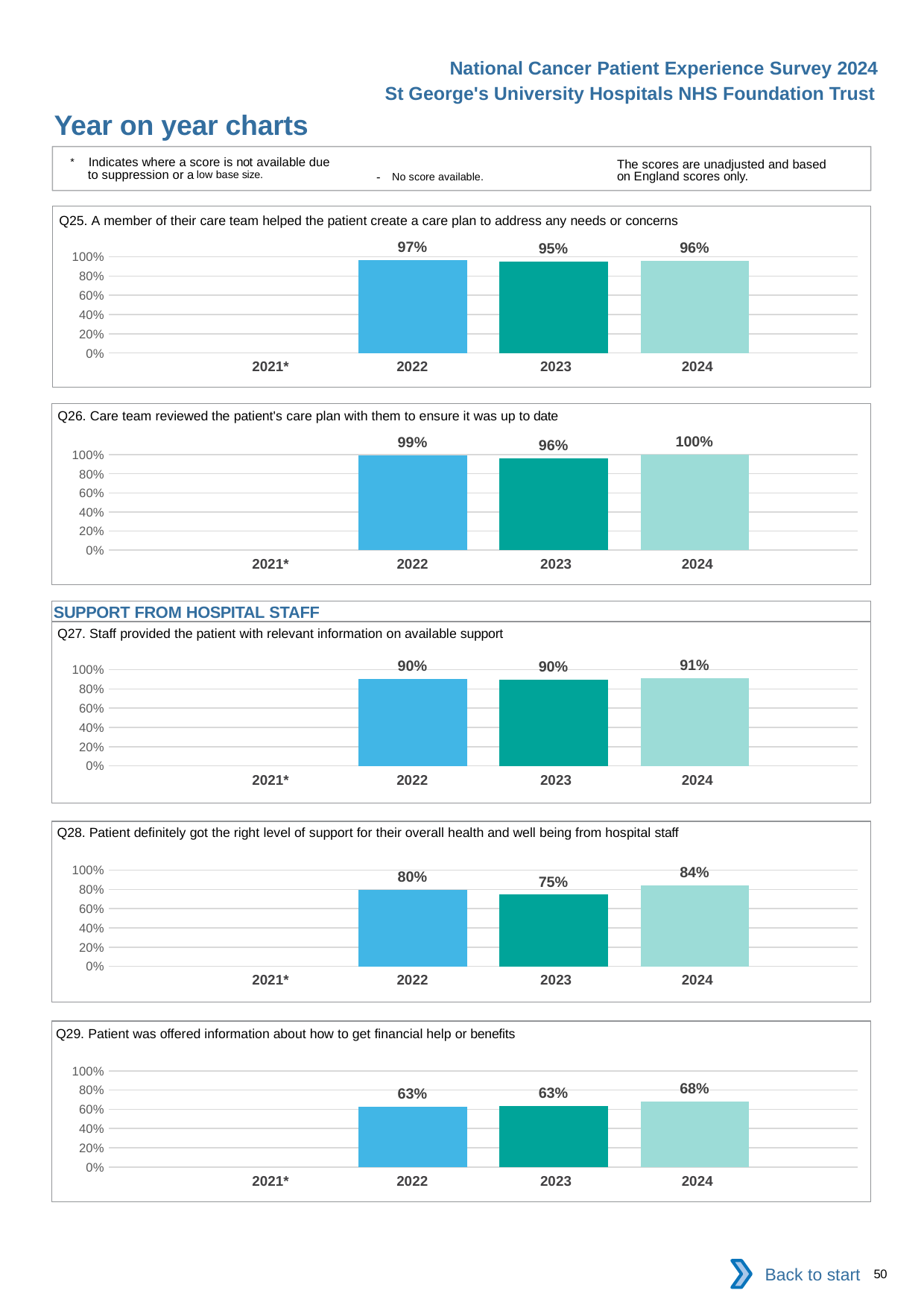
In the Q28 chart, what is the difference between the 2024 and 2023 values? 9% In the Q27 chart, which year has the highest value? 2024 In the Q27 chart, what is the value for 2023? 90% In the Q25 chart, what is the value for 2022? 97% In the Q25 chart, which year has the lowest value among those with a bar? 2023 In the Q26 chart, what is the difference between the 2022 and 2023 values? 3% How many year categories are shown on the x axis of the Q25 chart? 4 In the Q29 chart, is the value for 2022 greater or less than 80%? less In the Q26 chart, what is the value for 2024? 100% In the Q29 chart, what is the value for 2024? 68% What kind of chart is the Q29 chart? bar chart In the Q28 chart, which is larger, the value for 2022 or the value for 2023? 2022